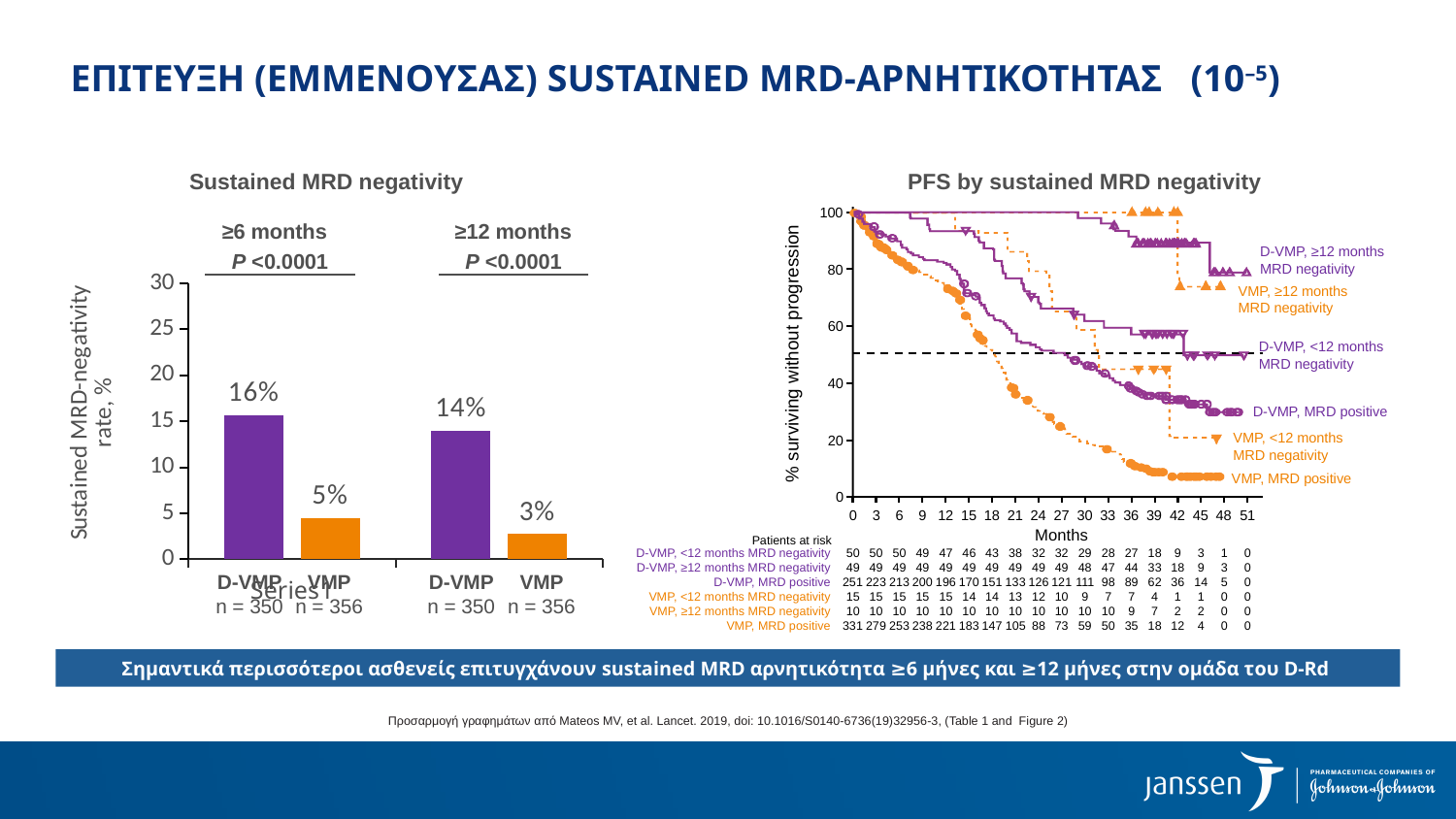
What type of chart is the 'Sustained MRD negativity' chart on the left? Bar chart In the 'Sustained MRD negativity' bar chart, what is the sustained MRD-negativity rate for D-VMP at ≥6 months? 16% In the 'Sustained MRD negativity' bar chart, which bar has the highest value? D-VMP, ≥6 months (16%) In the 'Sustained MRD negativity' bar chart, how many bars are plotted? 4 In the 'PFS by sustained MRD negativity' chart, is the value for the VMP, MRD positive curve at 36 months greater or less than 20? less In the 'Sustained MRD negativity' bar chart, what is the sustained MRD-negativity rate for VMP at ≥12 months? 3% In the 'PFS by sustained MRD negativity' chart, what is the label of the x axis? Months In the 'Sustained MRD negativity' bar chart, what is the difference between the D-VMP and VMP rates at ≥12 months? 11% In the 'Sustained MRD negativity' bar chart, which bar has the lowest value? VMP, ≥12 months (3%) In the 'Sustained MRD negativity' bar chart, what is the difference between the D-VMP and VMP rates at ≥6 months? 11% In the 'PFS by sustained MRD negativity' chart, is the value for the D-VMP, ≥12 months MRD negativity curve at 24 months greater or less than 80? greater In the 'Sustained MRD negativity' bar chart, which is larger: the D-VMP rate at ≥12 months or the VMP rate at ≥6 months? D-VMP at ≥12 months